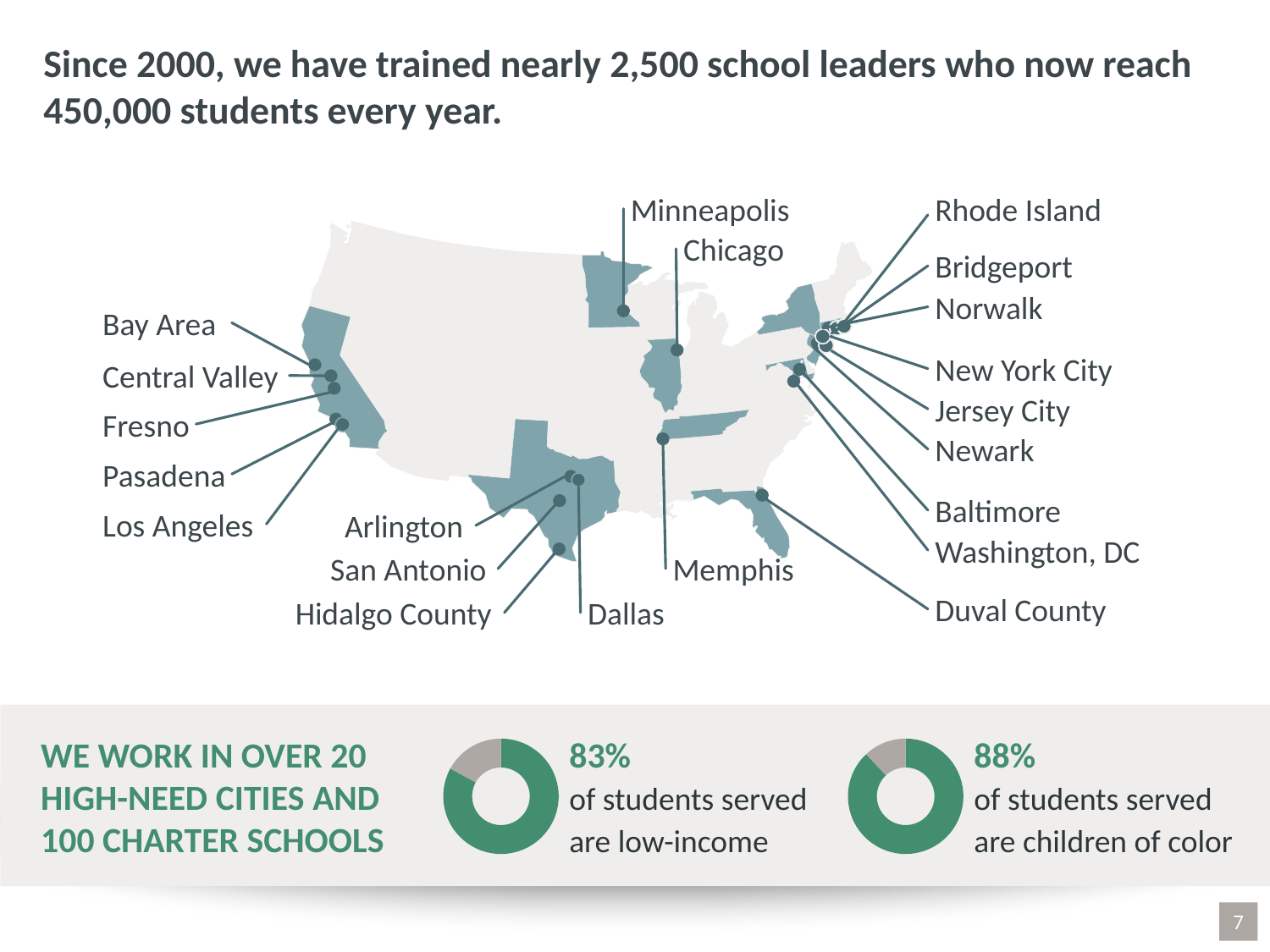
In the left donut chart, is the value for low-income students greater or less than 80%? greater What is the difference between the percentage of students served who are children of color and the percentage who are low-income? 5 percentage points What colour is the filled portion of the donut charts? green Which labelled location on the map is in Florida? Duval County In the right donut chart, is the value for children of color greater or less than 90%? less In the right donut chart, what percentage of students served are children of color? 88% What kind of chart is used to show the 83% and 88% figures at the bottom of the slide? donut chart How many locations are labelled on the map? 21 Which is larger: the share of students served who are low-income or the share who are children of color? children of color (88%) In the left donut chart, what percentage of students served are low-income? 83% How many donut charts are shown on the slide? 2